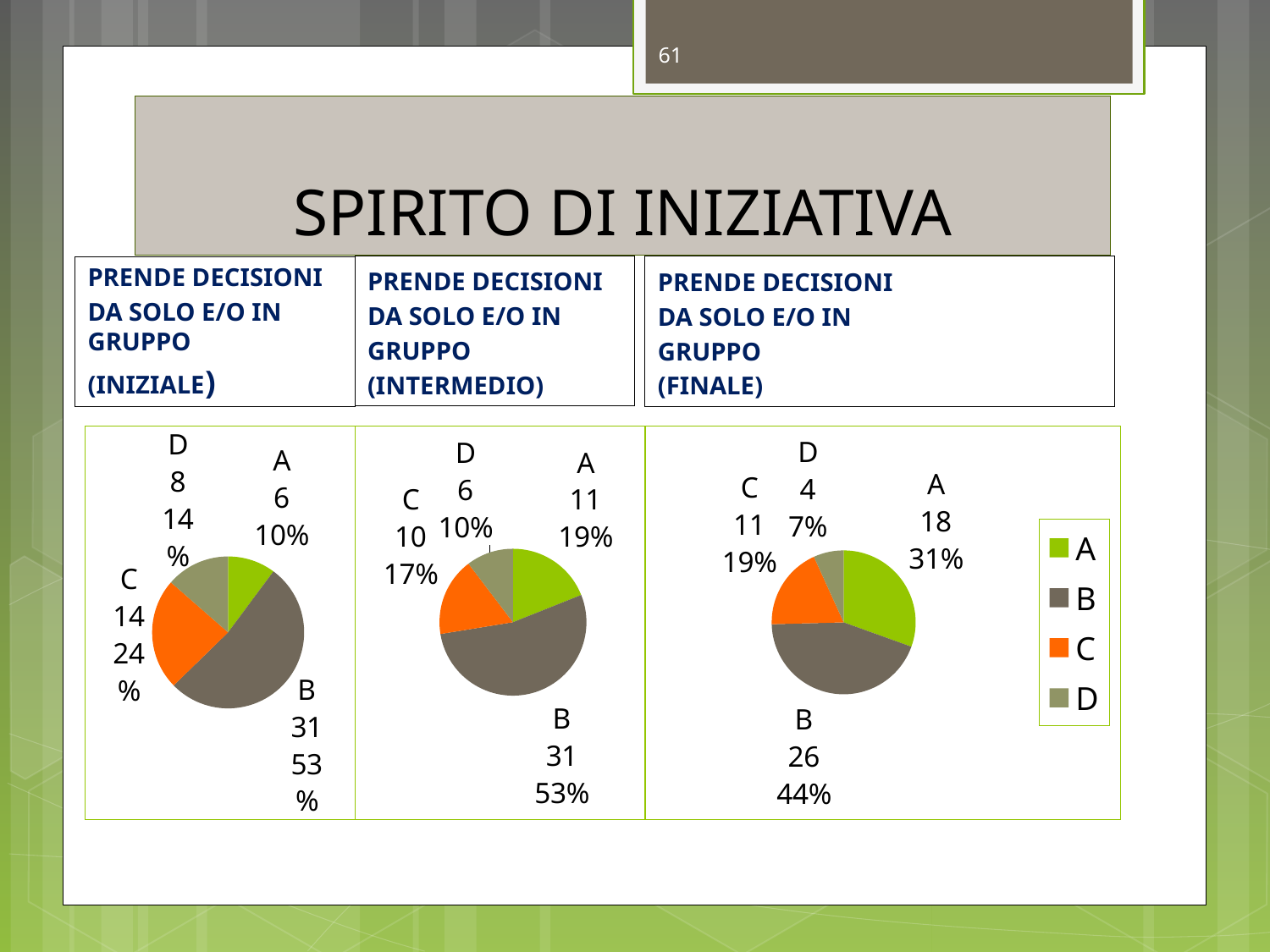
How many categories does the legend on the slide list? 4 What type of chart is used for the INIZIALE, INTERMEDIO and FINALE data? Pie chart In the INTERMEDIO pie chart, which is larger, the value for C or the value for D? C In the INTERMEDIO pie chart, what is the value for category A? 11 In the FINALE pie chart, what is the value for category B? 26 In the FINALE pie chart, which category has the smallest value? D In the INIZIALE pie chart, what is the value for category B? 31 In the INIZIALE pie chart, what share of the pie does category C represent? 24% In the INTERMEDIO pie chart, what share of the pie does category D represent? 10% In the FINALE pie chart, what is the difference between the values for B and A? 8 In the FINALE pie chart, what share of the pie does category A represent? 31% In the INIZIALE pie chart, which category has the largest value? B